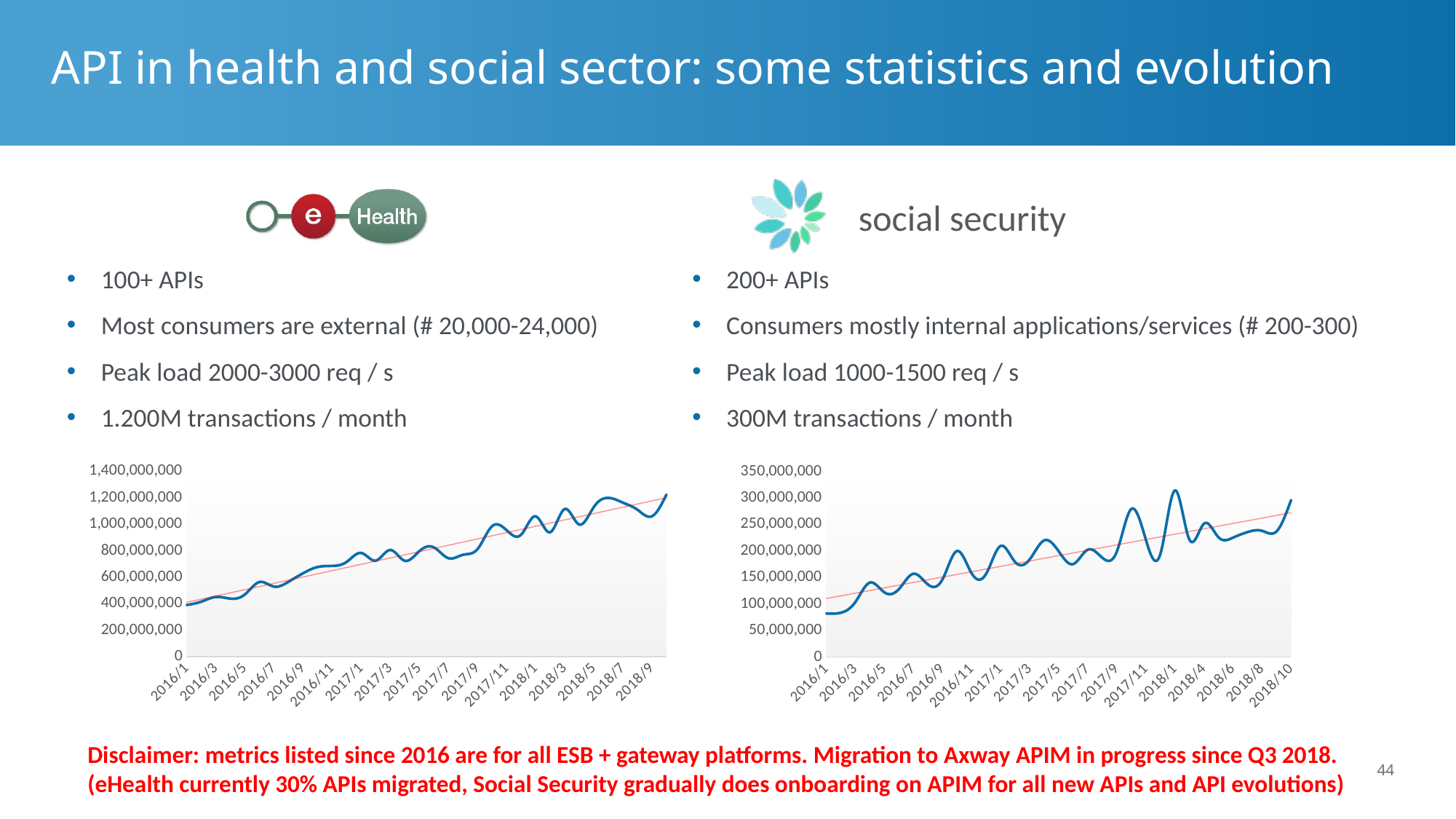
In the left (eHealth) chart, do the values generally rise or fall from 2016/1 to 2018/9? rise What is the highest value shown on the y axis of the right (social security) chart? 350,000,000 What kind of chart is the left chart under the eHealth section? line chart In the right (social security) chart, is the value for 2016/1 greater or less than 100,000,000? less In the left (eHealth) chart, is the value for 2017/1 greater or less than 600,000,000? greater In the left (eHealth) chart, is the value for 2018/9 greater or less than 1,000,000,000? greater In the right (social security) chart, do the values generally rise or fall from 2016/1 to 2018/10? rise What is the highest value shown on the y axis of the left (eHealth) chart? 1,400,000,000 What kind of chart is the right chart under the social security section? line chart